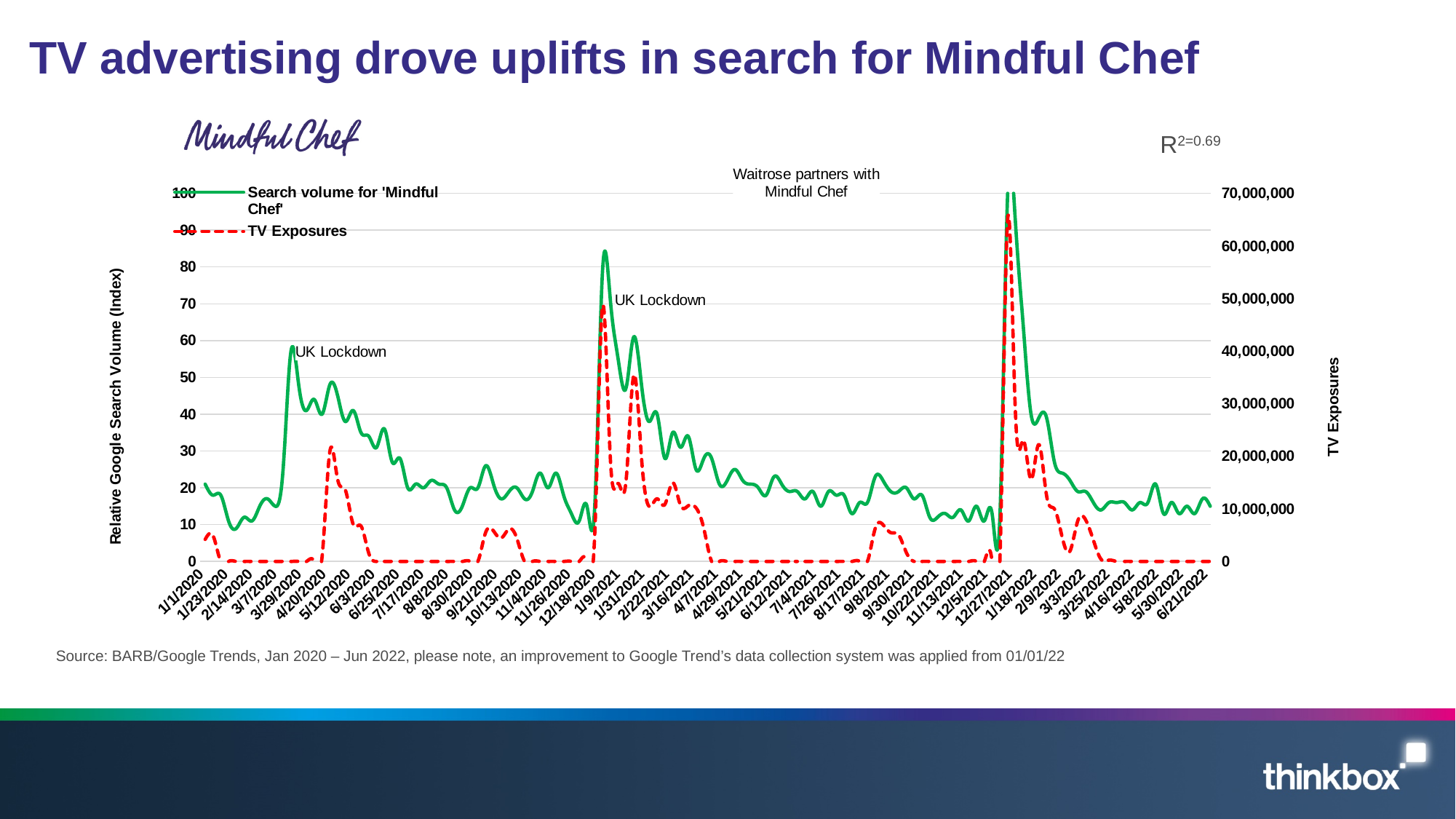
From the peak near 1/9/2021 through 12/5/2021, does the search volume line generally rise or fall? Fall What are the two series named in the chart's legend? Search volume for 'Mindful Chef' and TV Exposures Is the peak value of the search volume line near 3/29/2020 greater or less than 50 on the left axis? greater Which is higher: the search volume peak near 1/9/2021 or the search volume peak near 3/29/2020? The peak near 1/9/2021 Next to which annotated event does the search volume line reach its highest point? Waitrose partners with Mindful Chef What R-squared value is shown on the chart? R2=0.69 Is the peak of the TV Exposures line near 5/12/2020 greater or less than 30,000,000 on the right axis? less How many series does the chart's legend list? 2 Is the highest peak of the TV Exposures line, near 12/27/2021, greater or less than 60,000,000 on the right axis? greater What kind of chart is shown on the slide? Line chart